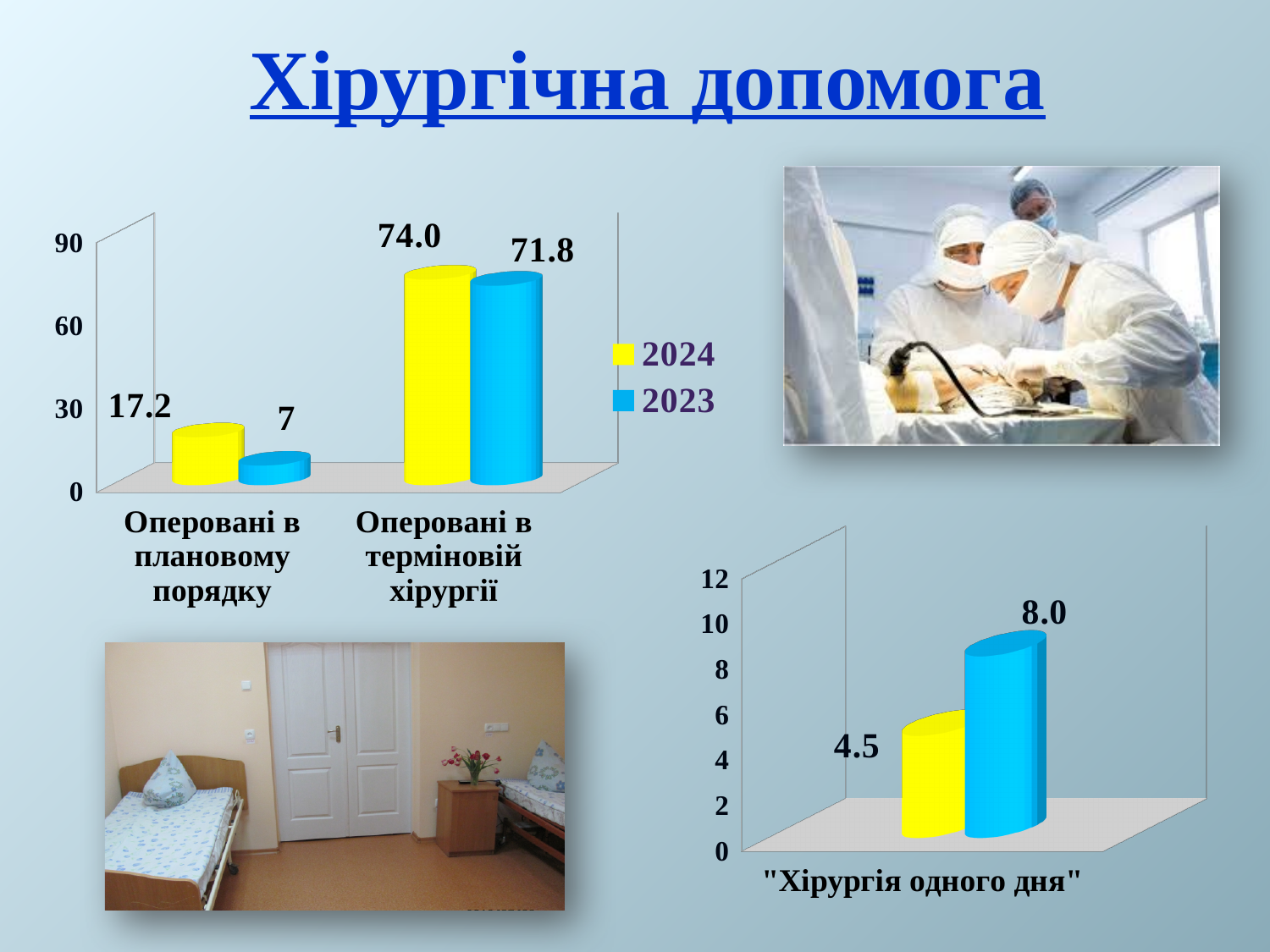
In the top-left chart, what is the 2024 value for "Оперовані в плановому порядку"? 17.2 In the top-left chart, what is the difference between the 2024 and 2023 values for "Оперовані в терміновій хірургії"? 2.2 In the bottom-right chart "Хірургія одного дня", what is the value of the blue bar? 8.0 In the top-left chart, which colour represents 2023? Blue In the top-left chart, how many categories are shown on the x axis? 2 In the top-left chart, what is the 2023 value for "Оперовані в терміновій хірургії"? 71.8 In the top-left chart, what is the 2023 value for "Оперовані в плановому порядку"? 7 In the bottom-right chart "Хірургія одного дня", what is the value of the yellow bar? 4.5 What kind of chart is the bottom-right chart titled "Хірургія одного дня"? Bar chart In the top-left chart, how many series does the legend list? 2 In the top-left chart, which is larger for "Оперовані в плановому порядку": the 2024 value or the 2023 value? 2024 In the bottom-right chart "Хірургія одного дня", what is the difference between the blue bar and the yellow bar? 3.5